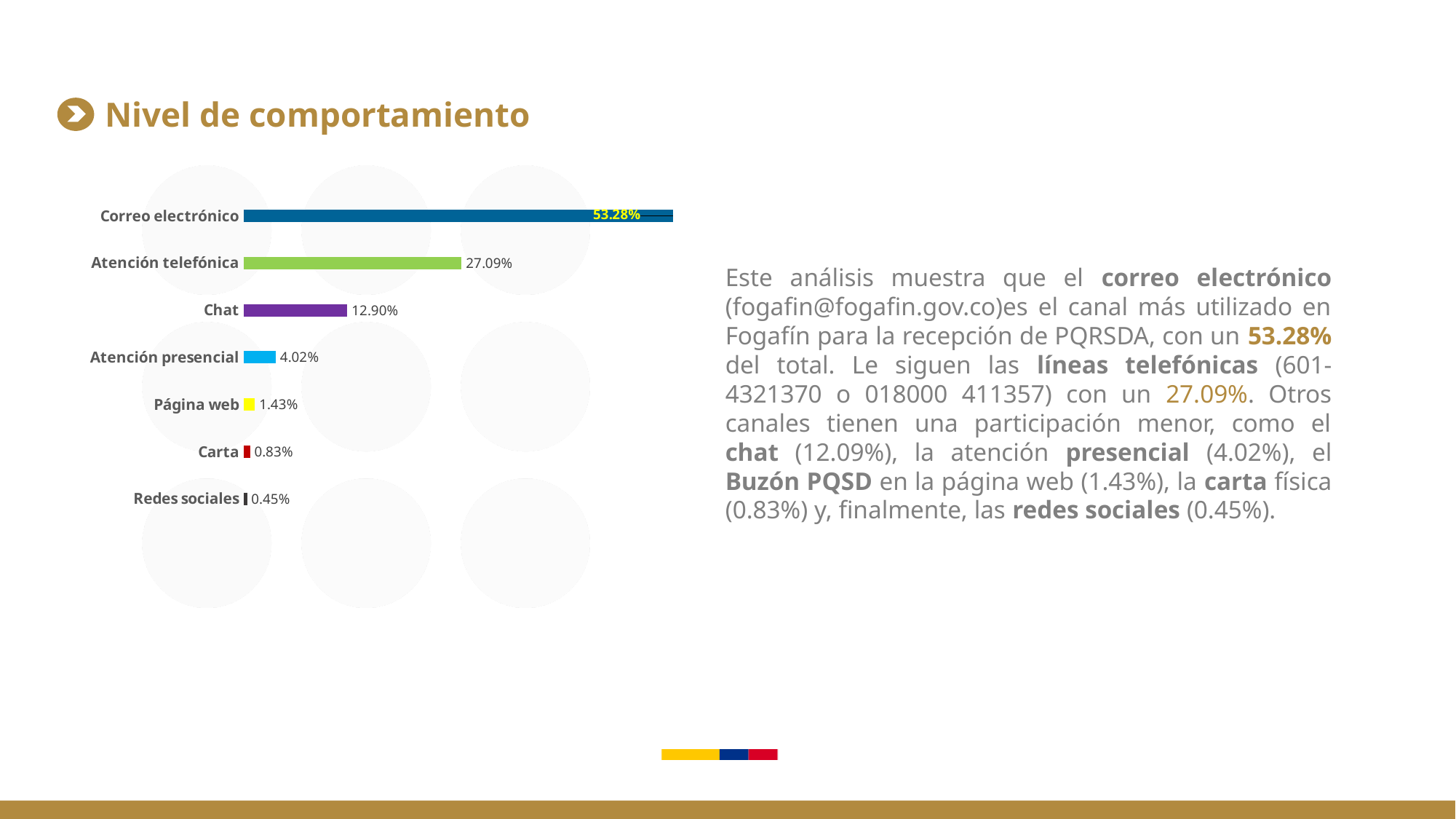
What is the value for Atención presencial? 4.02% What kind of chart is shown on the slide? Bar chart What is the value for Chat? 12.90% What is the value for Redes sociales? 0.45% What is the difference between the values for Correo electrónico and Atención telefónica? 26.19% Which category has the highest value? Correo electrónico How many categories are shown in the chart? 7 Which category has the lowest value? Redes sociales Which is larger, the value for Página web or the value for Carta? Página web What is the value for Atención telefónica? 27.09% What is the value for Correo electrónico? 53.28% What is the difference between the values for Atención telefónica and Chat? 14.19%